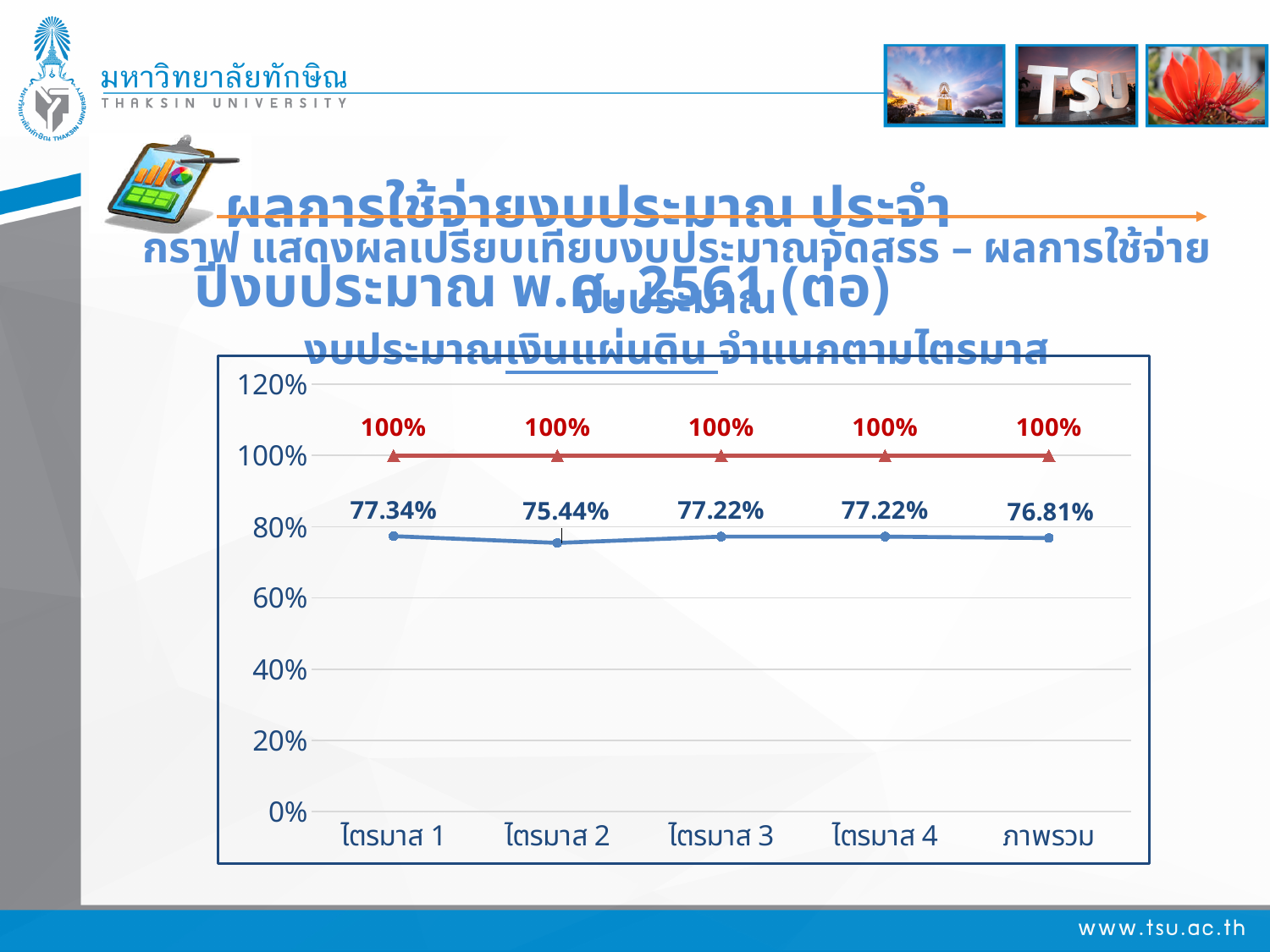
Which category has the lowest value in the blue series? ไตรมาส 2 What is the difference between the blue series values for ไตรมาส 1 and ไตรมาส 2? 1.90% How many categories are shown on the x axis? 5 What is the difference between the red and blue series values for ไตรมาส 2? 24.56% What is the value of the blue series for ไตรมาส 1? 77.34% What is the value of the blue series for ภาพรวม? 76.81% What is the value of the blue series for ไตรมาส 2? 75.44% What is the value of the red series for ไตรมาส 3? 100% Which category has the highest value in the blue series? ไตรมาส 1 Is the blue series value for ไตรมาส 4 greater or less than 80%? less What kind of chart is shown on the slide? line chart